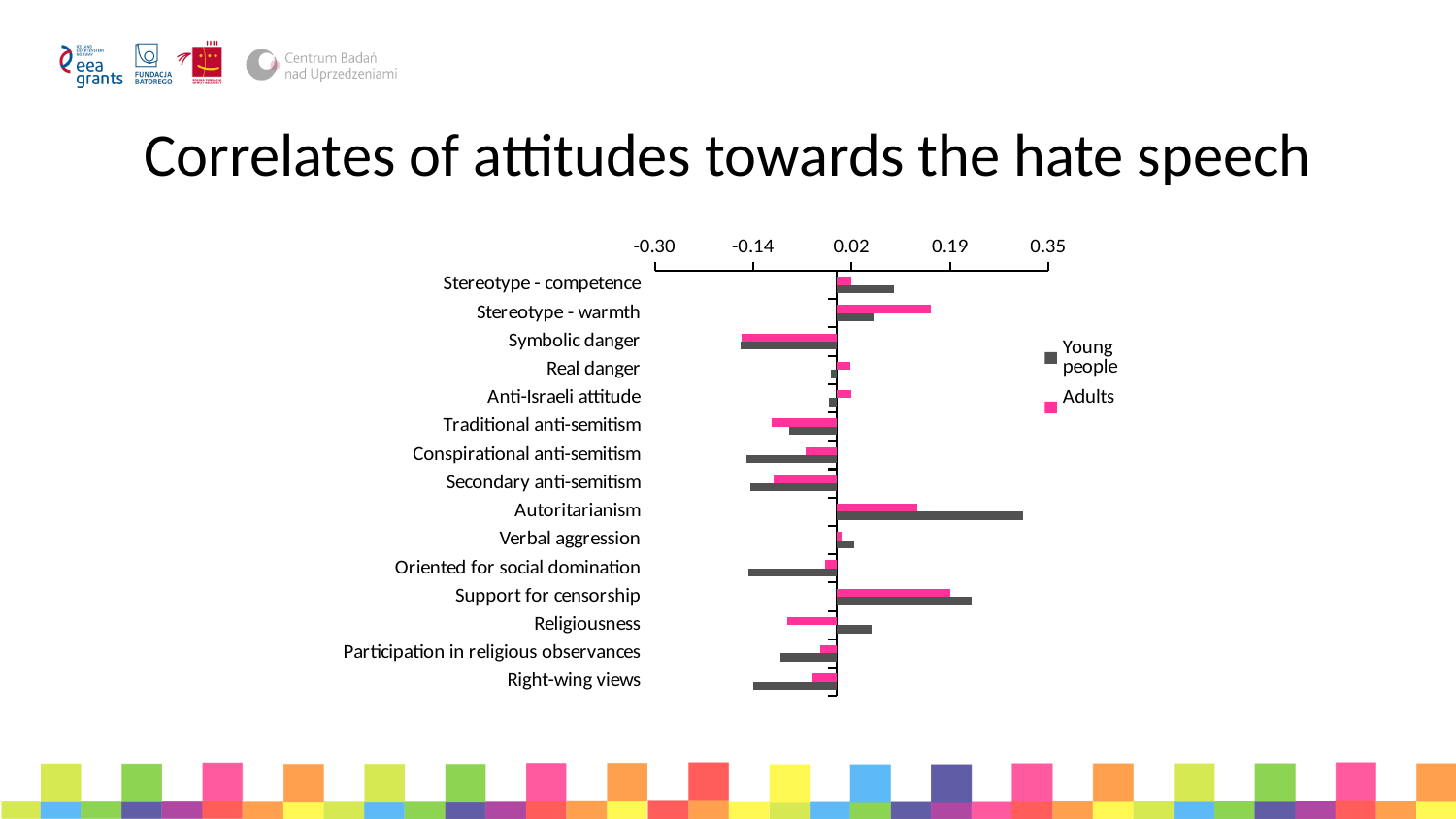
How many categories are plotted on the chart? 15 Is the value for Religiousness among Young people greater or less than 0.02? greater For Religiousness, which series has the larger value, Young people or Adults? Young people What is the title of the chart? Correlates of attitudes towards the hate speech Which category has the highest value for Young people? Autoritarianism For Stereotype - warmth, which series has the larger value, Young people or Adults? Adults Is the value for Support for censorship among Young people greater or less than 0.19? greater Is the value for Autoritarianism among Young people greater or less than 0.19? greater What kind of chart is shown on the slide? bar chart How many series does the legend list? 2 For Autoritarianism, which series has the larger value, Young people or Adults? Young people Which category has the lowest value for Adults? Symbolic danger